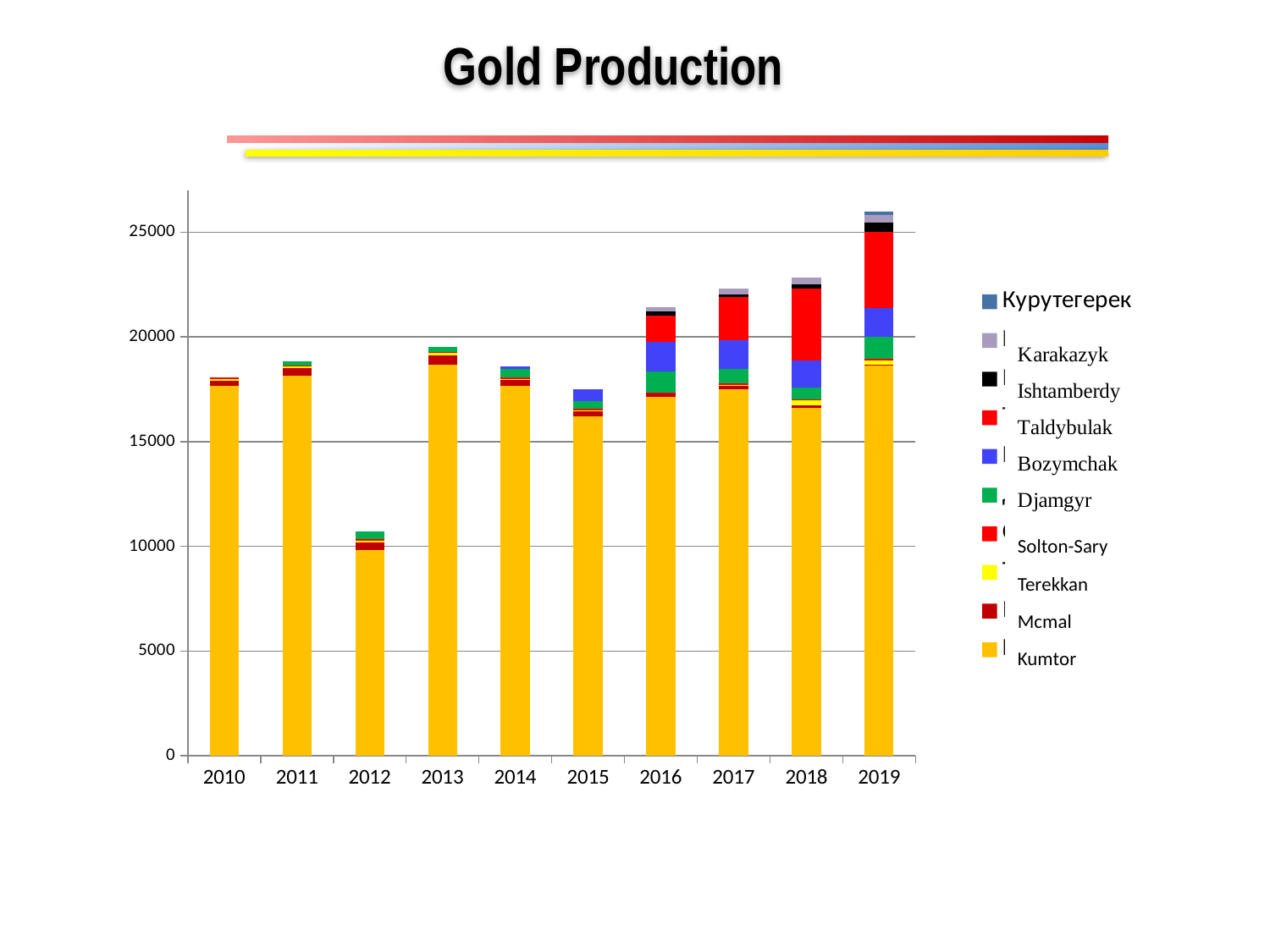
Is the total value for 2012 greater or less than 15000? less Is the total value for 2019 greater or less than 25000? greater What kind of chart is shown on the slide? Stacked bar chart Is the Kumtor value for 2019 greater or less than 20000? less Which year has the lowest total gold production? 2012 Which year has the larger total, 2018 or 2015? 2018 Do the total values rise or fall from 2015 to 2019? rise How many series does the legend list? 10 What is the title of the chart? Gold Production How many years are shown on the x axis of the chart? 10 Which year has the highest total gold production? 2019